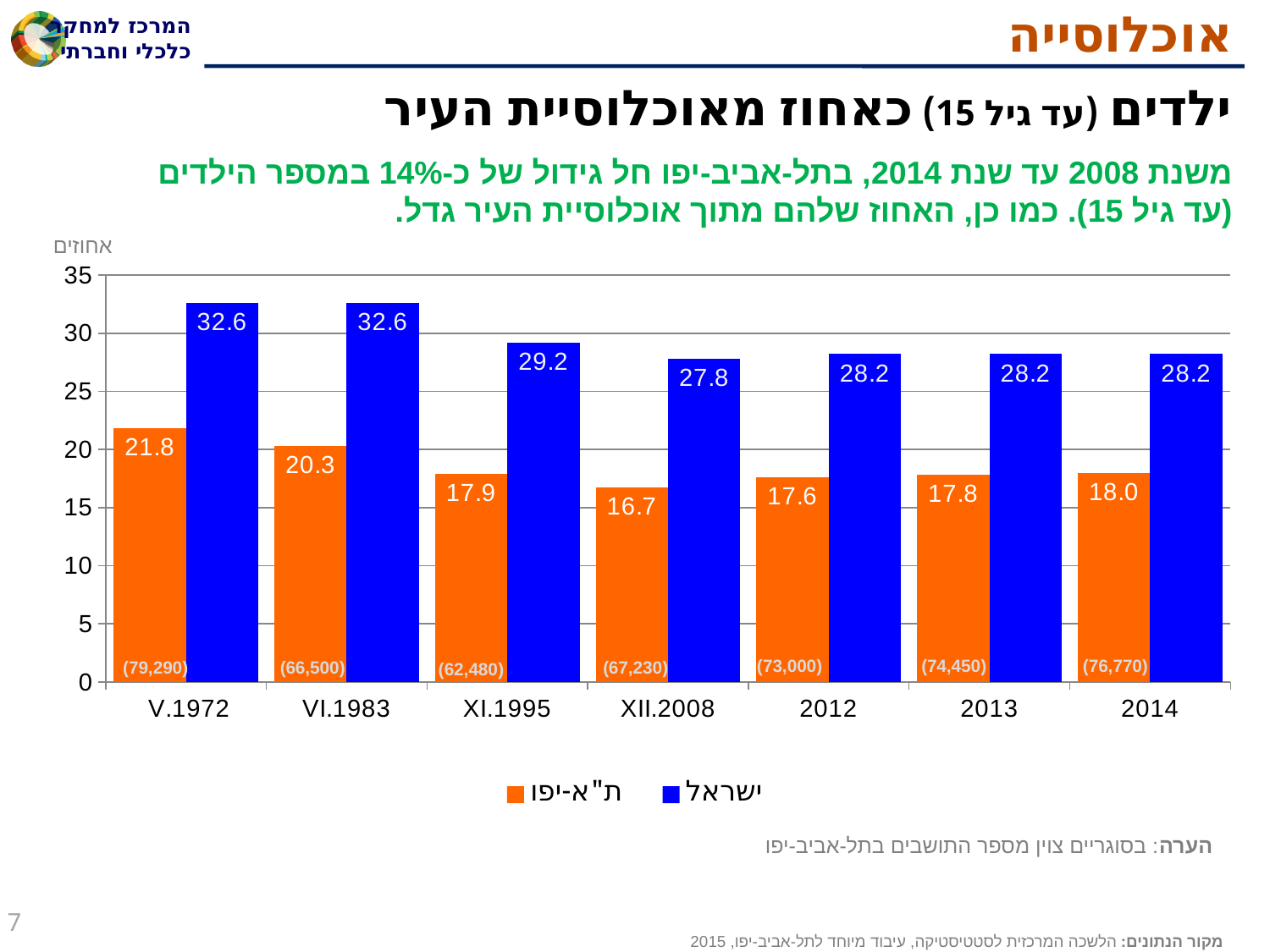
How many series does the legend list? 2 What is the value for ת"א-יפו in V.1972? 21.8 What is the value for ישראל in XI.1995? 29.2 What is the difference between the ישראל and ת"א-יפו values in 2013? 10.4 What number of residents is shown in parentheses for XII.2008? (67,230) What kind of chart is shown on the slide? bar chart What is the value for ת"א-יפו in 2014? 18.0 Which colour represents ת"א-יפו in the chart? orange Does the value for ישראל rise or fall from V.1972 to XII.2008? fall In which category is the value for ת"א-יפו lowest? XII.2008 Which is larger in VI.1983, the value for ת"א-יפו or for ישראל? ישראל How many categories are shown on the x axis? 7